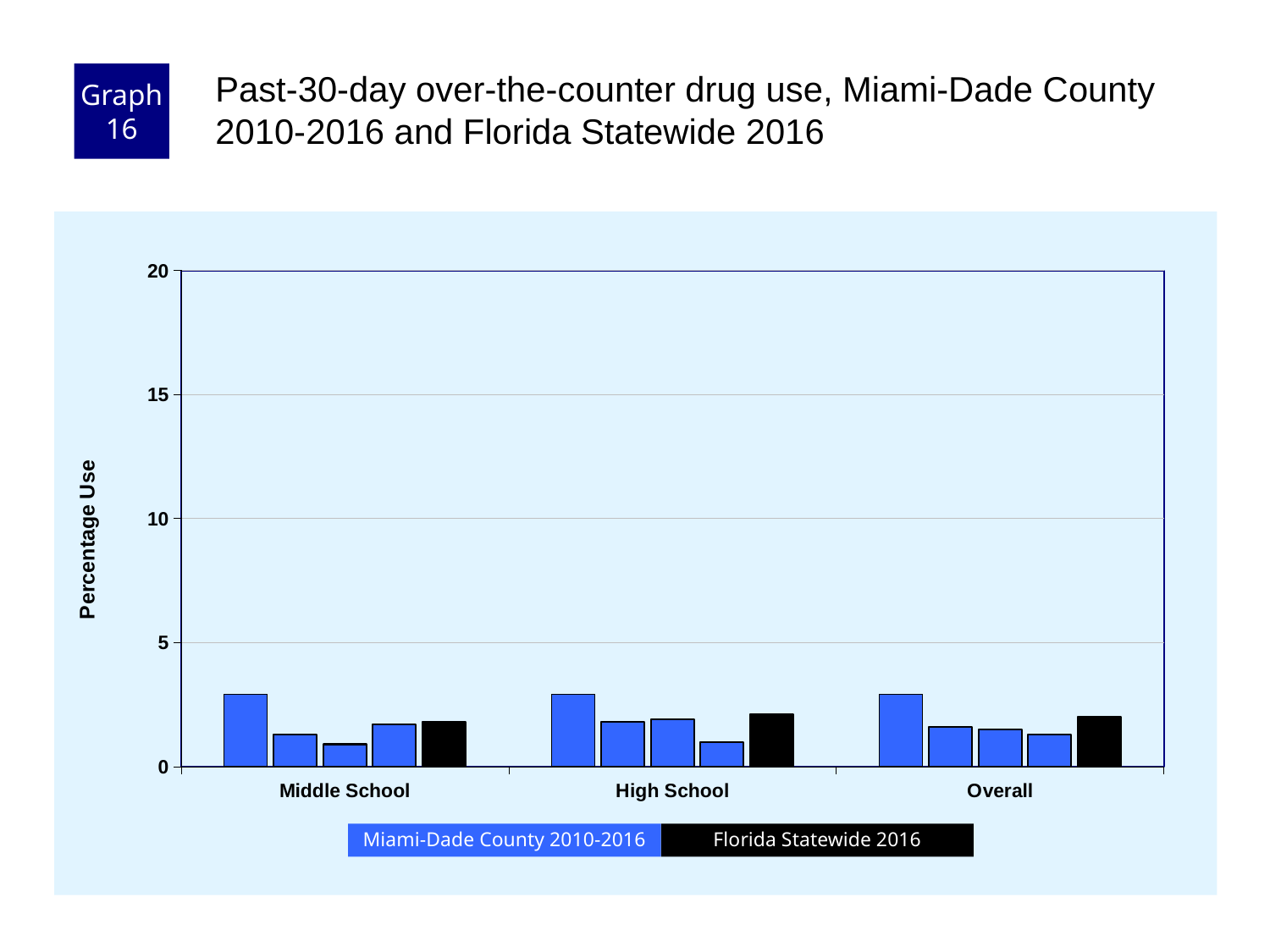
Which colour represents Florida Statewide 2016 in the legend? black How many series does the legend list? 2 In the Middle School category, which is larger: the first (leftmost) Miami-Dade County bar or the Florida Statewide 2016 bar? the first Miami-Dade County bar What is the highest value shown on the y axis? 20 What kind of chart is shown on the slide? bar chart Is the tallest bar in the Overall category greater or less than 5? less What is the label on the y axis? Percentage Use Is the value for Florida Statewide 2016 in the High School category greater or less than 5? less How many categories are shown along the x axis? 3 Are any of the bars on the chart greater than 5? no In the High School category, which is larger: the first (leftmost) Miami-Dade County bar or the Florida Statewide 2016 bar? the first Miami-Dade County bar